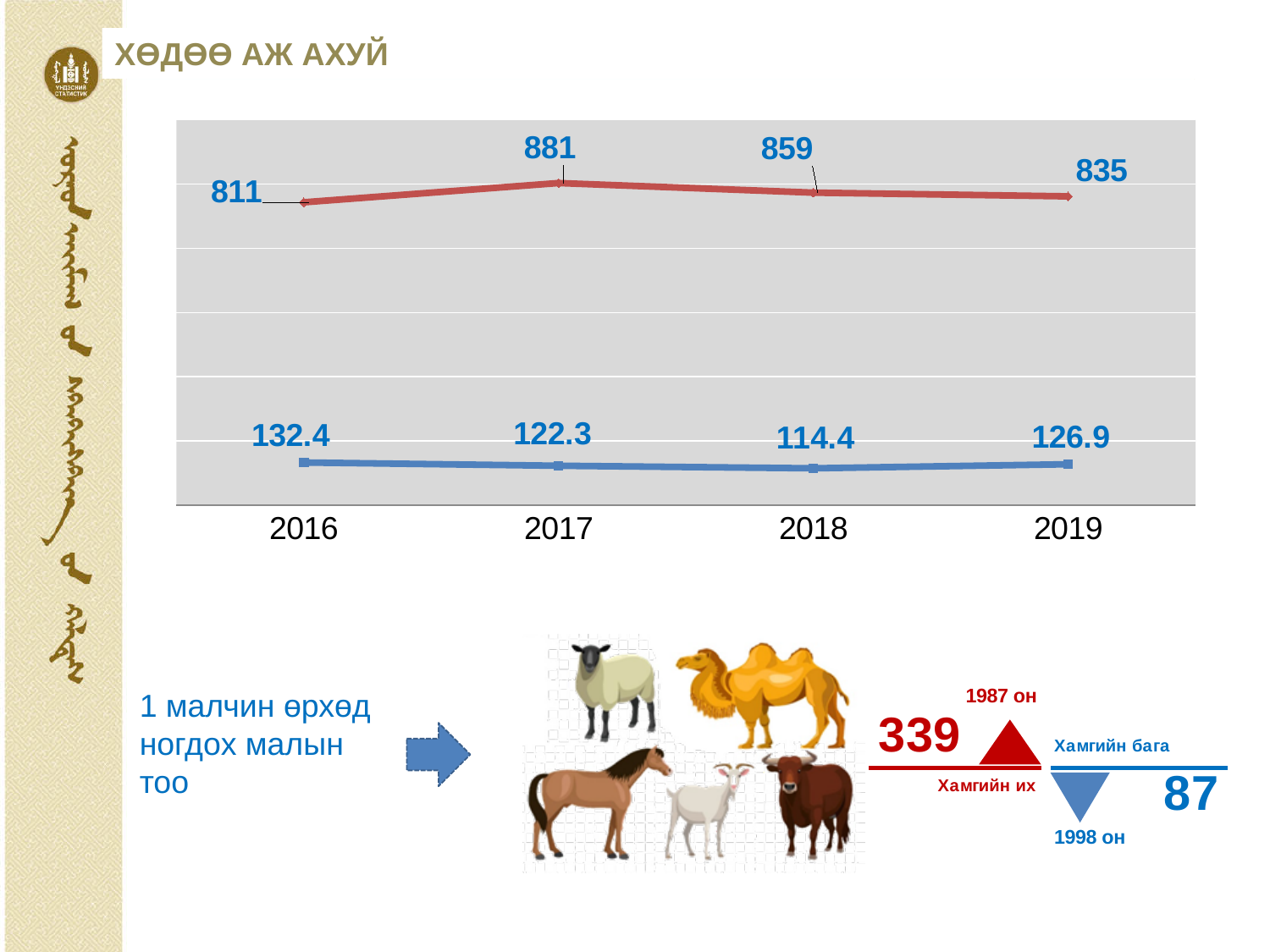
How many years are shown on the x axis of the chart? 4 Which is larger, the red line's value in 2018 or in 2019? 2018 What is the value of the blue line in 2018? 114.4 What is the difference between the blue line's values in 2016 and 2018? 18.0 In which year does the blue line reach its lowest value? 2018 In which year does the red line reach its highest value? 2017 What kind of chart is shown on the slide? line chart What is the value of the red line in 2019? 835 What is the value of the blue line in 2016? 132.4 What is the difference between the red line's values in 2017 and 2016? 70 Does the red line rise or fall from 2017 to 2019? fall What is the value of the red line in 2017? 881